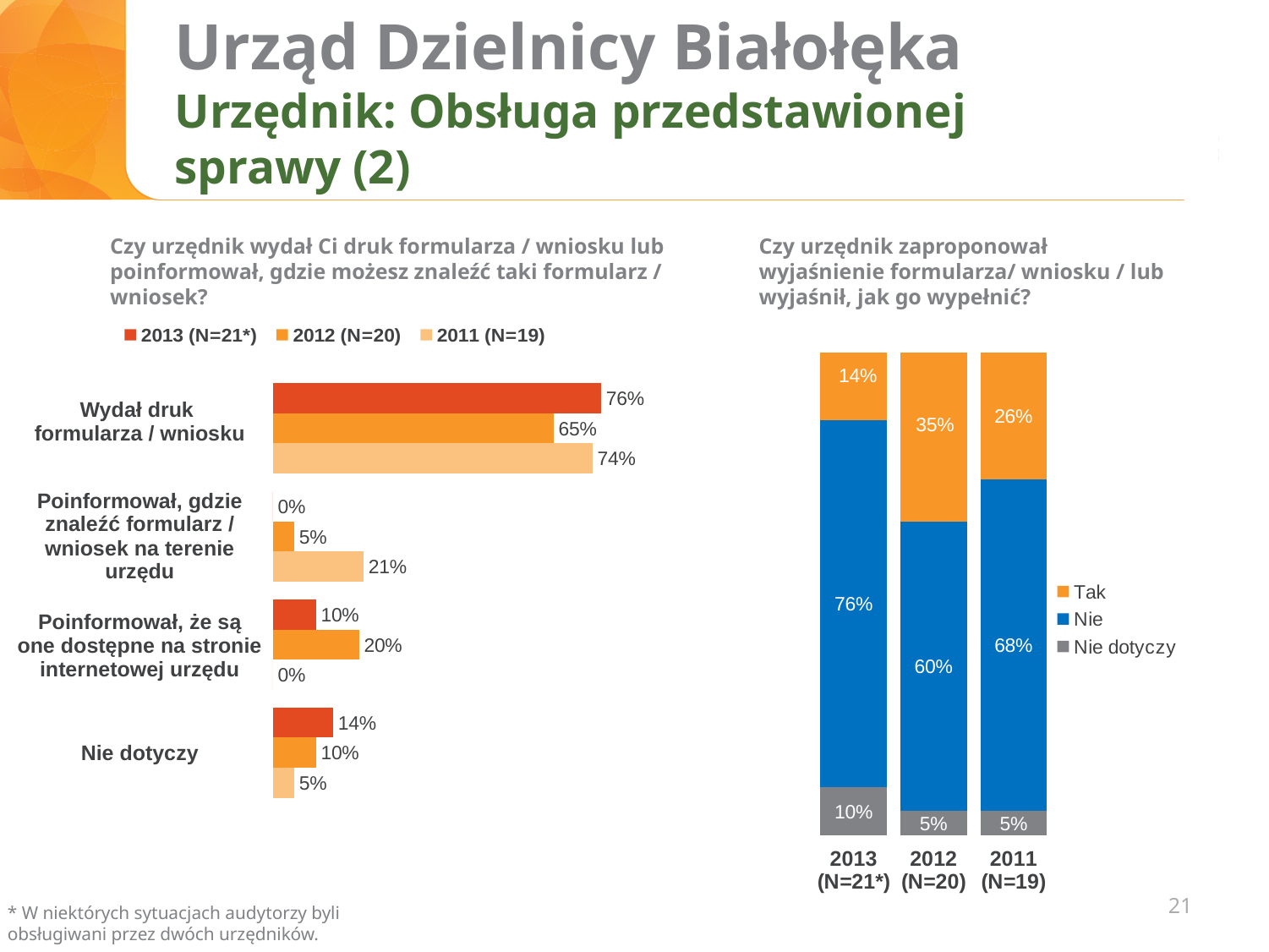
In the left chart, for "Nie dotyczy", which year has the larger value: 2013 or 2011? 2013 How many series does the legend of the left chart list? 3 In the right chart, what is the "Nie" value for 2012 (N=20)? 60% In the right chart, what is the difference between the "Nie" values for 2013 and 2011? 8% In the left chart, what is the 2013 value for "Wydał druk formularza / wniosku"? 76% What type of chart is the right chart? Stacked bar chart In the left chart, what is the 2011 value for "Poinformował, gdzie znaleźć formularz / wniosek na terenie urzędu"? 21% How many categories are shown in the left chart? 4 In the right chart, what is the total of the 2013 (N=21*) stacked bar? 100% In the left chart, what is the difference between the 2013 and 2012 values for "Wydał druk formularza / wniosku"? 11% In the left chart, which category has the highest 2012 value? Wydał druk formularza / wniosku In the right chart, which year has the highest "Tak" value? 2012 (N=20)